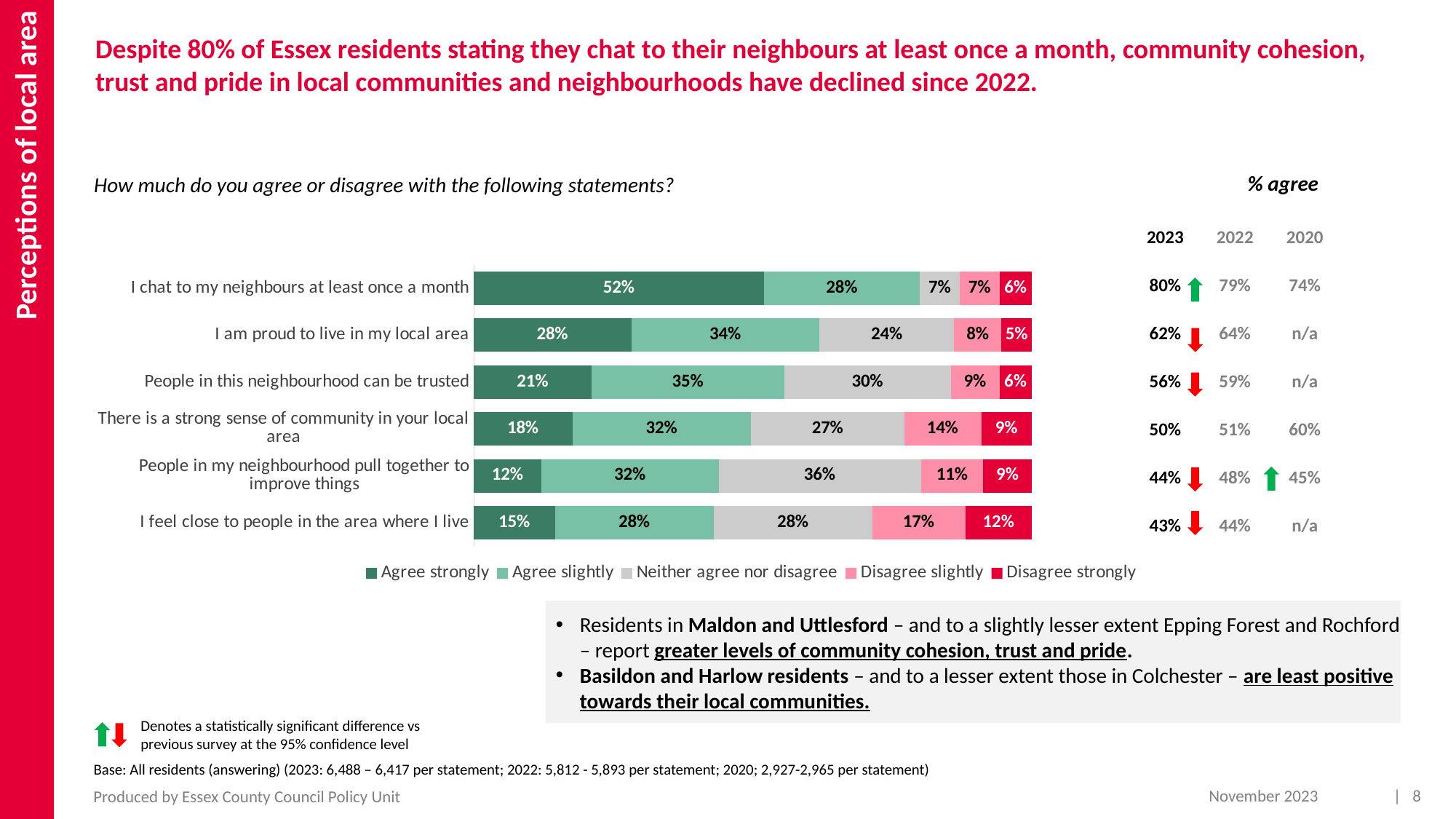
Which statement has the highest 'Agree strongly' value? I chat to my neighbours at least once a month What is the difference between the 'Agree slightly' values for 'People in this neighbourhood can be trusted' and 'I am proud to live in my local area'? 1% How many statements (categories) are plotted in the chart? 6 Which legend entry is shown in the darkest green colour? Agree strongly Which statement has the lowest 'Agree strongly' value? People in my neighbourhood pull together to improve things What kind of chart is shown on the slide? Stacked bar chart Which is larger: the 'Disagree slightly' value for 'I feel close to people in the area where I live' or for 'There is a strong sense of community in your local area'? I feel close to people in the area where I live What is the 'Disagree strongly' value for 'I feel close to people in the area where I live'? 12% How many series does the chart legend list? 5 What is the 'Neither agree nor disagree' value for 'People in my neighbourhood pull together to improve things'? 36% What is the total of the stacked bar for 'I am proud to live in my local area'? 99% What is the 'Agree strongly' value for 'I chat to my neighbours at least once a month'? 52%